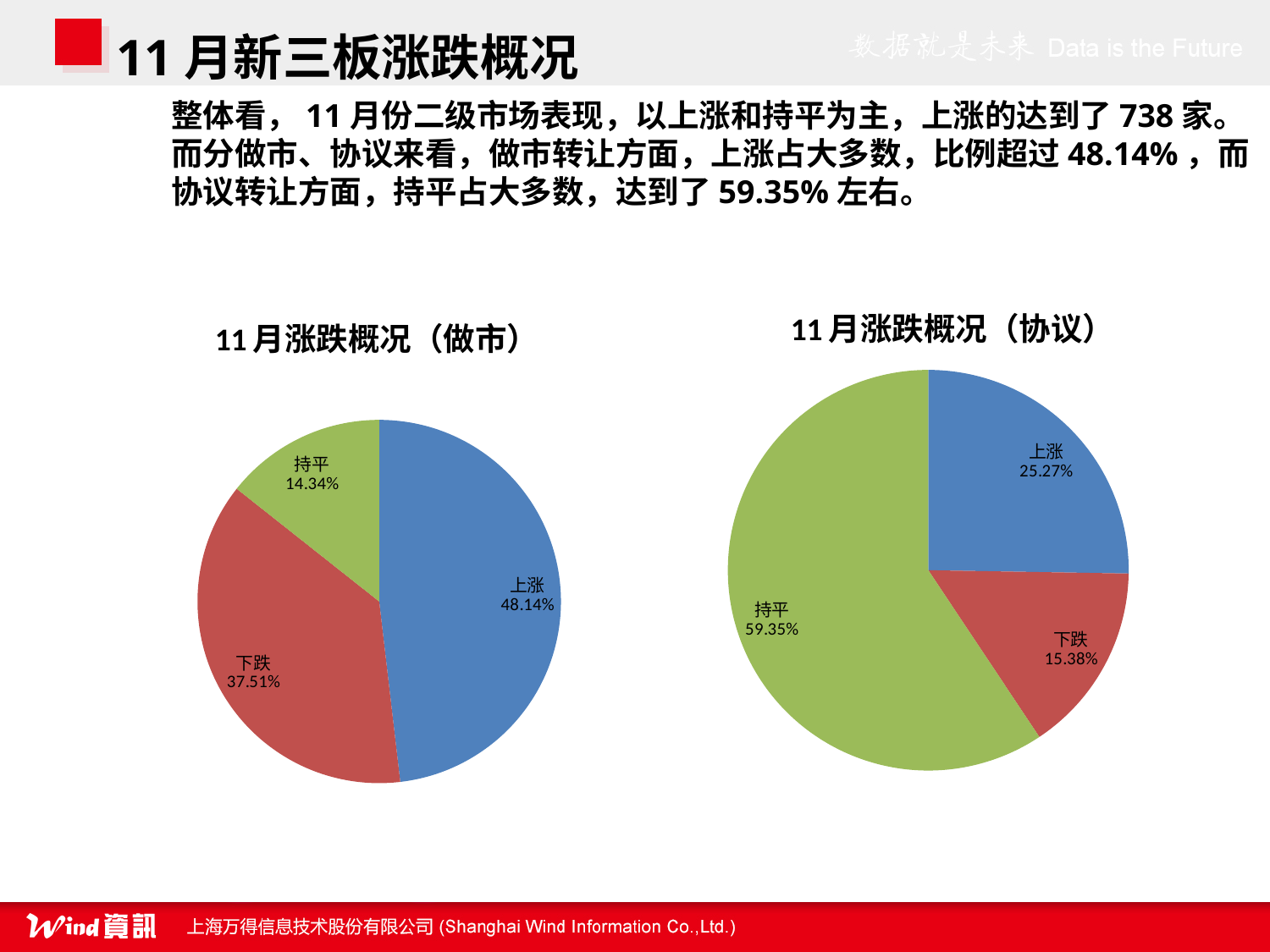
In the chart titled 11月涨跌概况（做市）, what is the share for 持平? 14.34% In the chart titled 11月涨跌概况（做市）, what is the share for 上涨? 48.14% In the chart titled 11月涨跌概况（做市）, what is the difference between the shares of 上涨 and 下跌? 10.63% What kind of chart is the chart titled 11月涨跌概况（做市）? pie chart In the chart titled 11月涨跌概况（协议）, which category has the smallest slice? 下跌 In the chart titled 11月涨跌概况（协议）, what is the share for 持平? 59.35% In the chart titled 11月涨跌概况（协议）, what is the share for 下跌? 15.38% In the chart titled 11月涨跌概况（协议）, what is the share for 上涨? 25.27% In the chart titled 11月涨跌概况（做市）, what is the share for 下跌? 37.51% How many slices does the chart titled 11月涨跌概况（协议） have? 3 In the chart titled 11月涨跌概况（协议）, which is larger, the share of 上涨 or the share of 下跌? 上涨 In the chart titled 11月涨跌概况（做市）, which category has the largest slice? 上涨